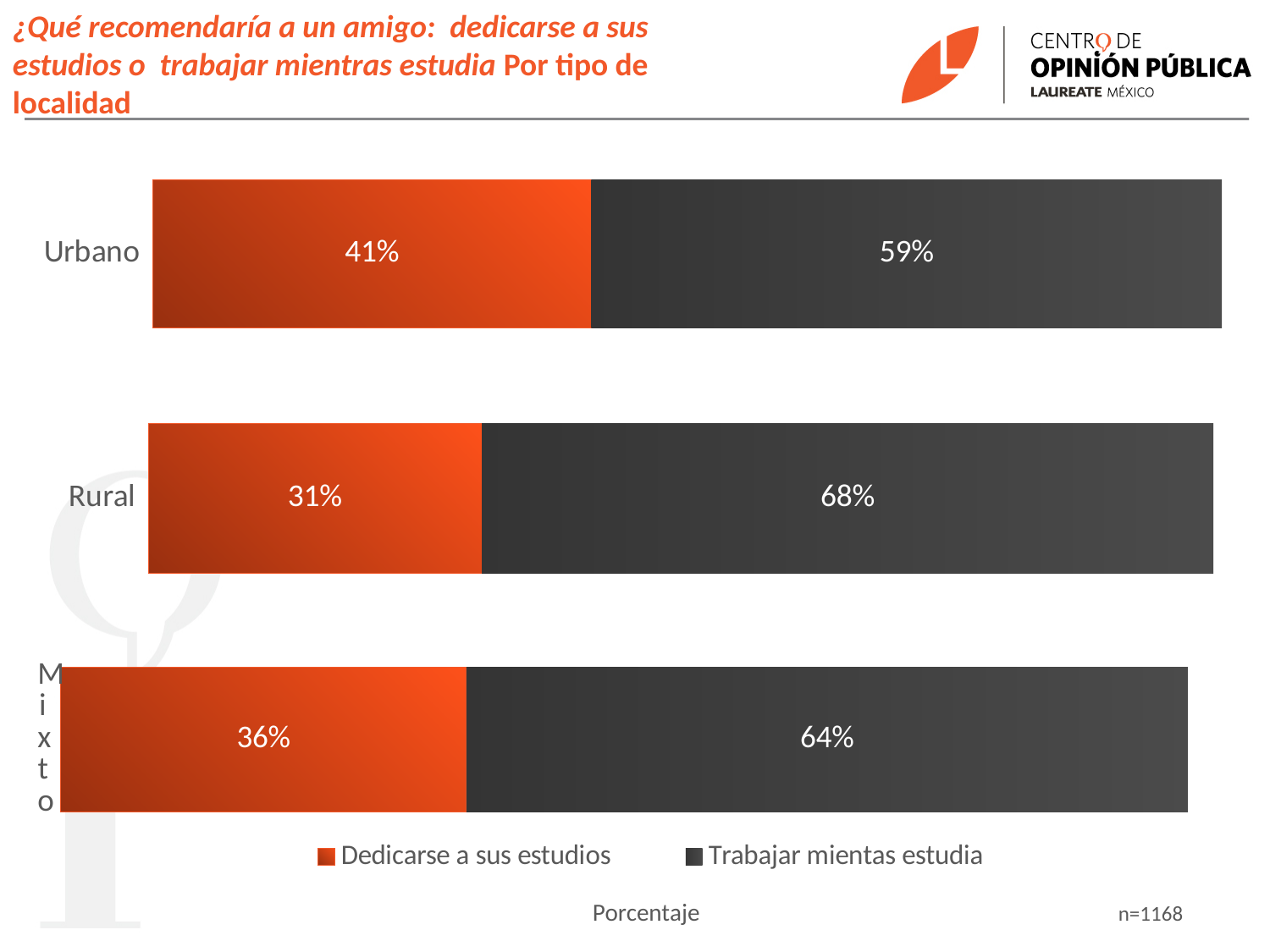
What is the value for 'Dedicarse a sus estudios' in the Mixto category? 36% What percentage of Rural respondents recommend 'Trabajar mientas estudia'? 68% What is the total of the Urbano bar? 100% What kind of chart is shown on the slide? Stacked bar chart Which is larger: 'Dedicarse a sus estudios' for Mixto or for Rural? Mixto How many series does the legend list? 2 Which locality type has the highest share for 'Dedicarse a sus estudios'? Urbano How many locality types are shown in the chart? 3 What sample size (n) is shown on the slide? n=1168 What is the difference between the 'Trabajar mientas estudia' values for Rural and Urbano? 9% What percentage of Urbano respondents recommend 'Dedicarse a sus estudios'? 41% Which locality type has the lowest share for 'Dedicarse a sus estudios'? Rural